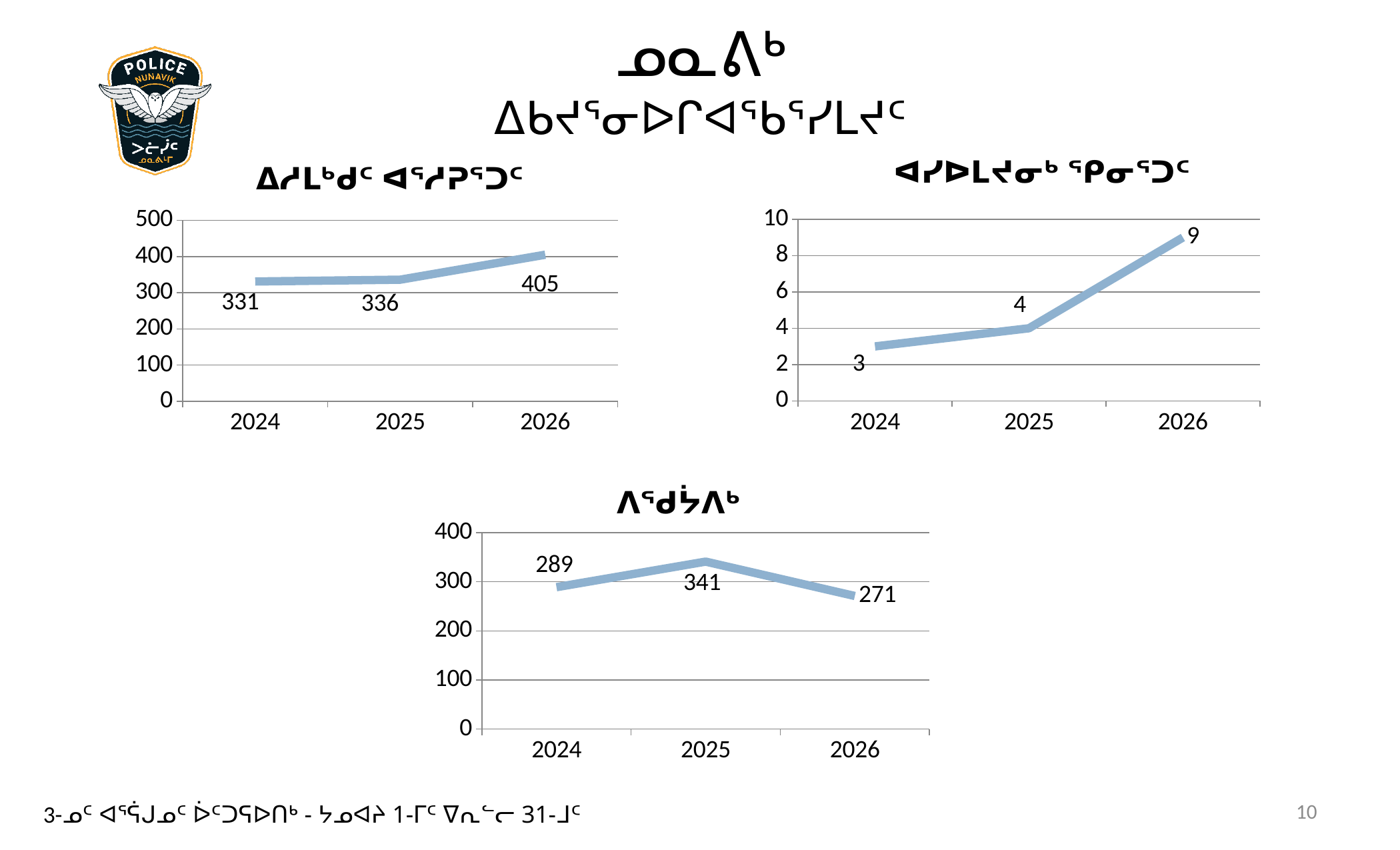
In the top-left chart, what is the difference between the 2026 and 2025 values? 69 What kind of chart is the top-right chart? line chart In the top-right chart, what is the difference between the 2026 and 2024 values? 6 In the top-left chart, what is the value for 2026? 405 In the top-right chart, which year has the highest value? 2026 In the bottom chart, what is the value for 2025? 341 In the top-right chart, what is the value for 2025? 4 In the bottom chart, which is larger, the value for 2024 or the value for 2026? 2024 In the top-left chart, do the values rise or fall from 2024 to 2026? rise In the bottom chart, which year has the lowest value? 2026 How many data points are plotted in the bottom chart? 3 In the top-left chart, what is the value for 2024? 331